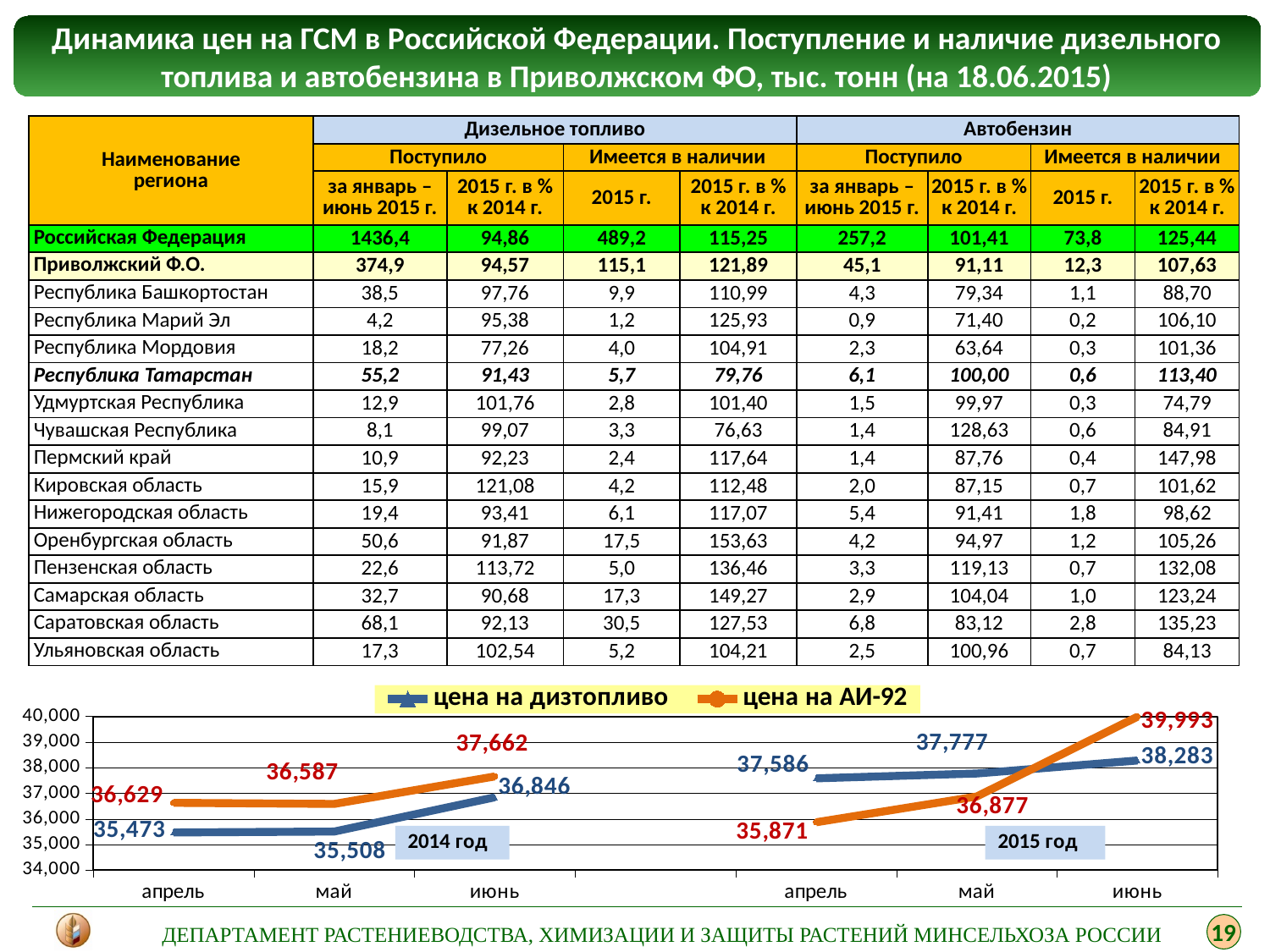
In the line chart, what is the value of цена на дизтопливо for май 2015? 37,777 In the line chart, does цена на АИ-92 rise or fall from апрель 2015 to июнь 2015? rise In the line chart, which month has the lowest value for цена на дизтопливо? апрель 2014 In the line chart, which is larger in апрель 2015: цена на дизтопливо or цена на АИ-92? цена на дизтопливо In the line chart, which series is drawn in orange? цена на АИ-92 In the line chart, what is the value of цена на АИ-92 for июнь 2015? 39,993 In the line chart, what is the difference between цена на АИ-92 and цена на дизтопливо in июнь 2015? 1,710 In the line chart, what is the value of цена на АИ-92 for апрель 2015? 35,871 How many series does the legend of the line chart list? 2 In the line chart, which month has the highest value for цена на АИ-92? июнь 2015 In the line chart, what is the value of цена на дизтопливо for апрель 2014? 35,473 What kind of chart is shown at the bottom of the slide? line chart